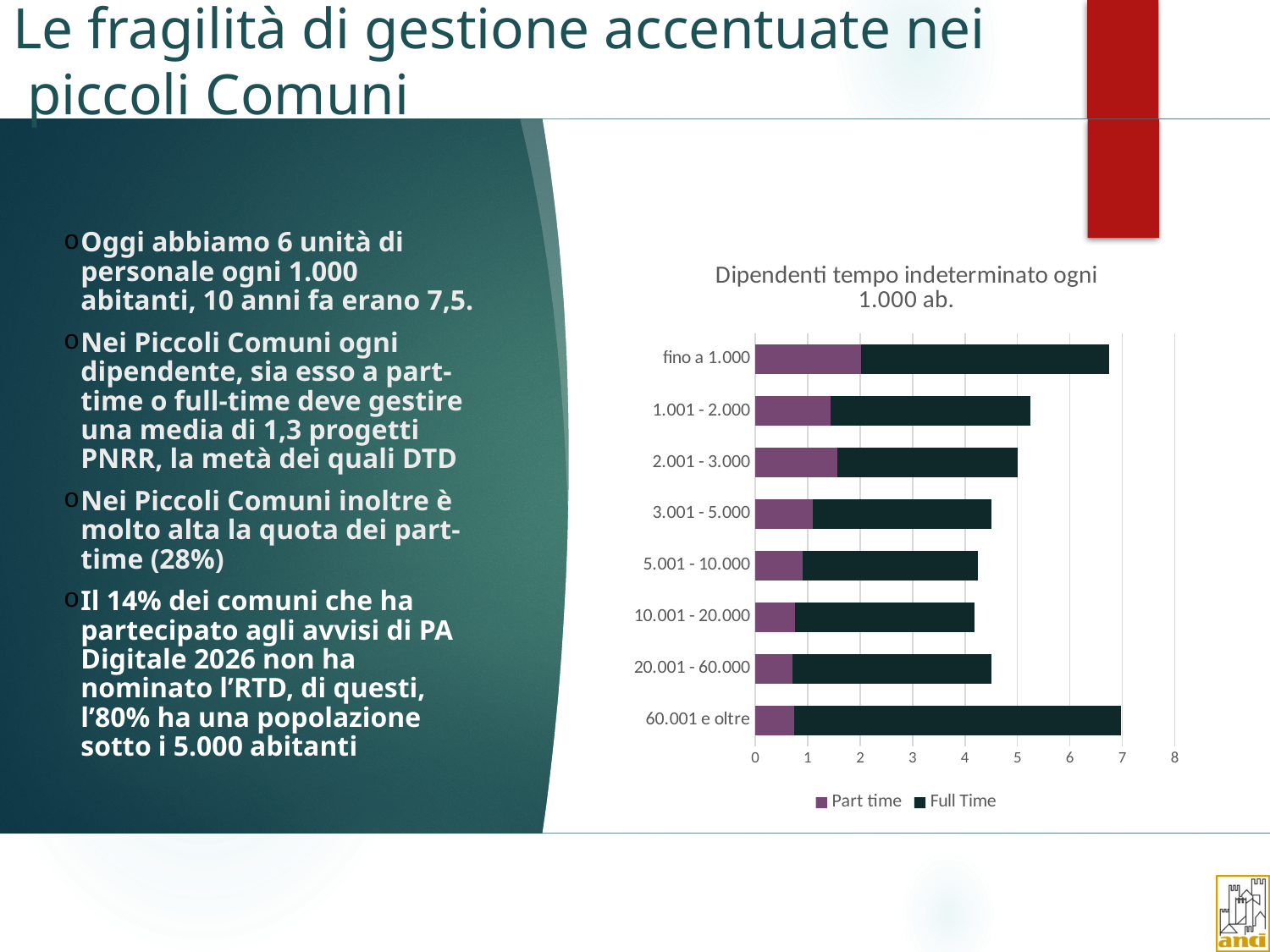
What kind of chart is shown on the slide? Bar chart How many series does the chart legend list? 2 Is the Part time value for '60.001 e oltre' greater or less than 1? less Is the total bar for '3.001 - 5.000' greater or less than 5? less Is the total bar for 'fino a 1.000' greater or less than 6? greater Which category has the largest Part time segment? fino a 1.000 Which series is shown in purple in the chart legend? Part time How many population categories are shown on the chart? 8 Which has the larger Part time segment, 'fino a 1.000' or '60.001 e oltre'? fino a 1.000 Which category has the longest total bar? 60.001 e oltre What is the title of the chart? Dipendenti tempo indeterminato ogni 1.000 ab.